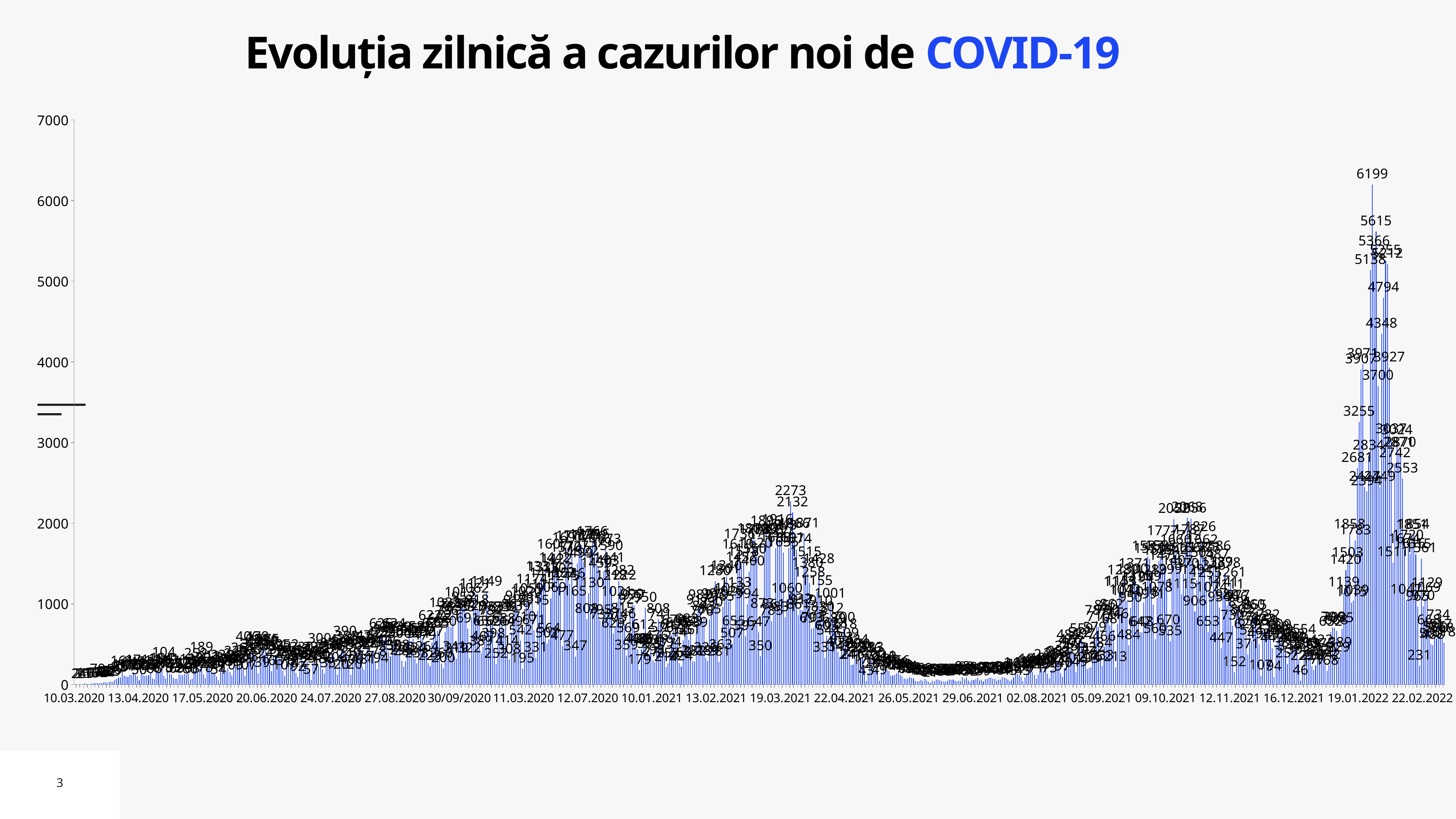
What is the title of the chart? Evoluția zilnică a cazurilor noi de COVID-19 What is the last date label on the horizontal axis? 22.02.2022 What is the difference between the two highest labelled values, 6199 and 5615? 584 Do the values rise or fall between 19.03.2021 and 26.05.2021? fall Which is larger: the peak labelled 2273 around 19.03.2021 or the peak labelled 6199 around 19.01.2022? 6199 Are the values around 29.06.2021 greater or less than 1000? less What is the highest daily value labelled on the chart? 6199 Is the highest peak of the chart greater or less than 6000? greater What is the highest tick value shown on the vertical axis? 7000 What kind of chart is shown on the slide? bar chart Do the values rise or fall between 16.12.2021 and 19.01.2022? rise What is the first date label on the horizontal axis? 10.03.2020